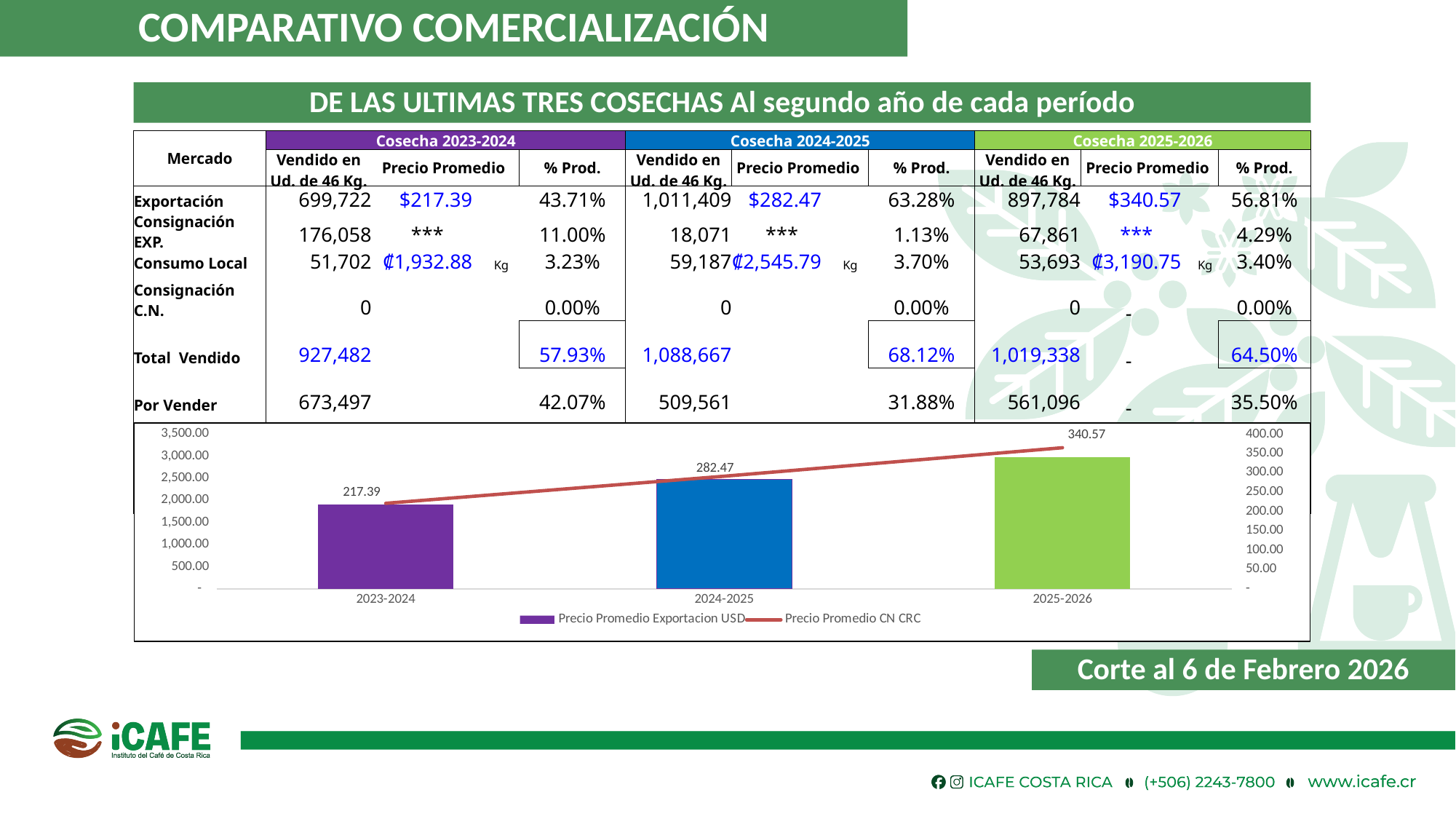
Is the Precio Promedio Exportacion USD bar larger for 2024-2025 or for 2023-2024? 2024-2025 How many series does the chart legend list? 2 What is the Precio Promedio Exportacion USD value for 2023-2024 in the chart? 217.39 Which harvest period has the highest Precio Promedio Exportacion USD bar? 2025-2026 Which harvest period has the lowest Precio Promedio Exportacion USD bar? 2023-2024 Is the Precio Promedio CN CRC line value for 2025-2026 greater or less than 2,500.00 on the left axis? greater What is the Precio Promedio Exportacion USD value for 2025-2026 in the chart? 340.57 How many harvest periods are shown on the x axis of the chart? 3 What is the difference between the Precio Promedio Exportacion USD values for 2025-2026 and 2023-2024? 123.18 Do the Precio Promedio Exportacion USD bars rise or fall from 2023-2024 to 2025-2026? Rise What kind of chart is shown at the bottom of the slide? Combined bar and line chart What is the Precio Promedio Exportacion USD value for 2024-2025 in the chart? 282.47